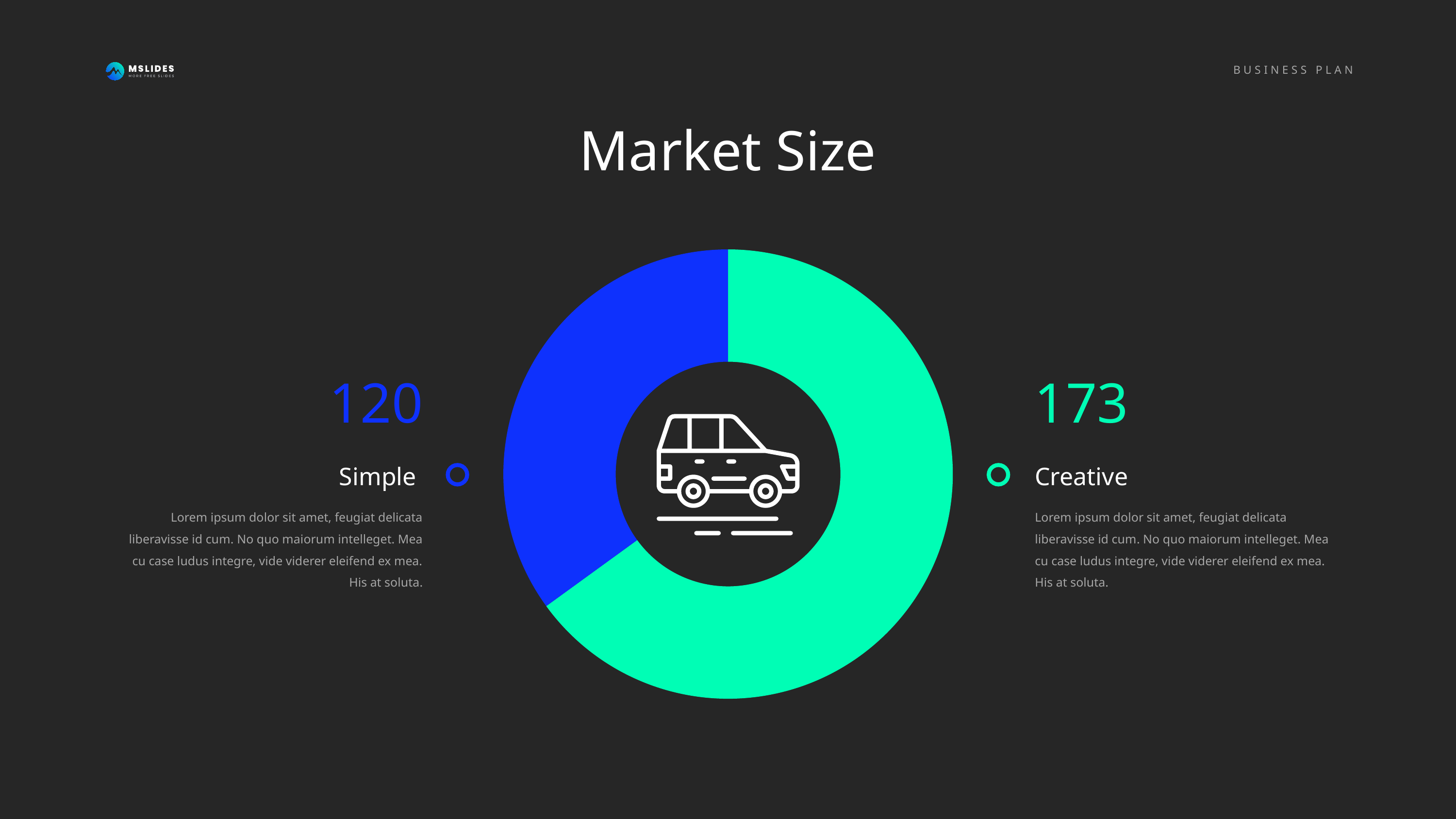
Which is larger, the value for Simple or the value for Creative? Creative What is the total of the two values shown in the chart? 293 What kind of chart is shown on the slide? Donut chart What is the value for Simple? 120 What is the value for Creative? 173 What colour is the Simple slice of the donut chart? Blue How many categories does the donut chart show? 2 What is the title of the slide containing the chart? Market Size What is the difference between the values for Creative and Simple? 53 Which category has the largest slice of the donut chart? Creative Which category has the smallest slice of the donut chart? Simple